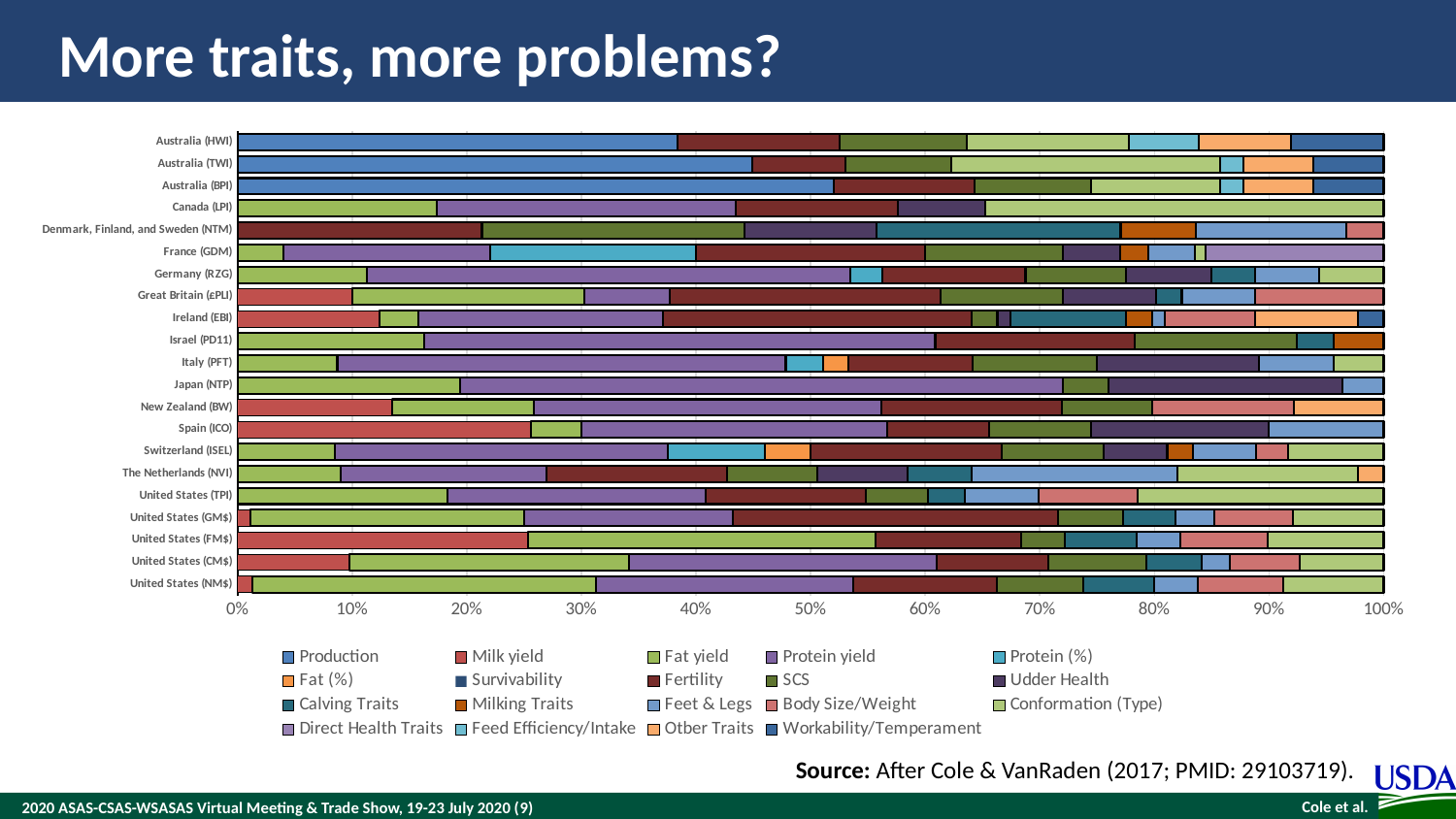
What is the highest value shown on the x axis of the chart? 100% How many series does the chart legend list? 19 Is the Production share for Australia (TWI) greater or less than 40%? greater Is the Production share for Australia (HWI) greater or less than 30%? greater Is the Milk yield share for United States (FM$) greater or less than 20%? greater Which category has the larger Production share, Australia (BPI) or Canada (LPI)? Australia (BPI) What kind of chart is shown on the slide? Stacked bar chart What is the title of the slide containing the chart? More traits, more problems? How many countries or indices are listed as categories on the chart? 21